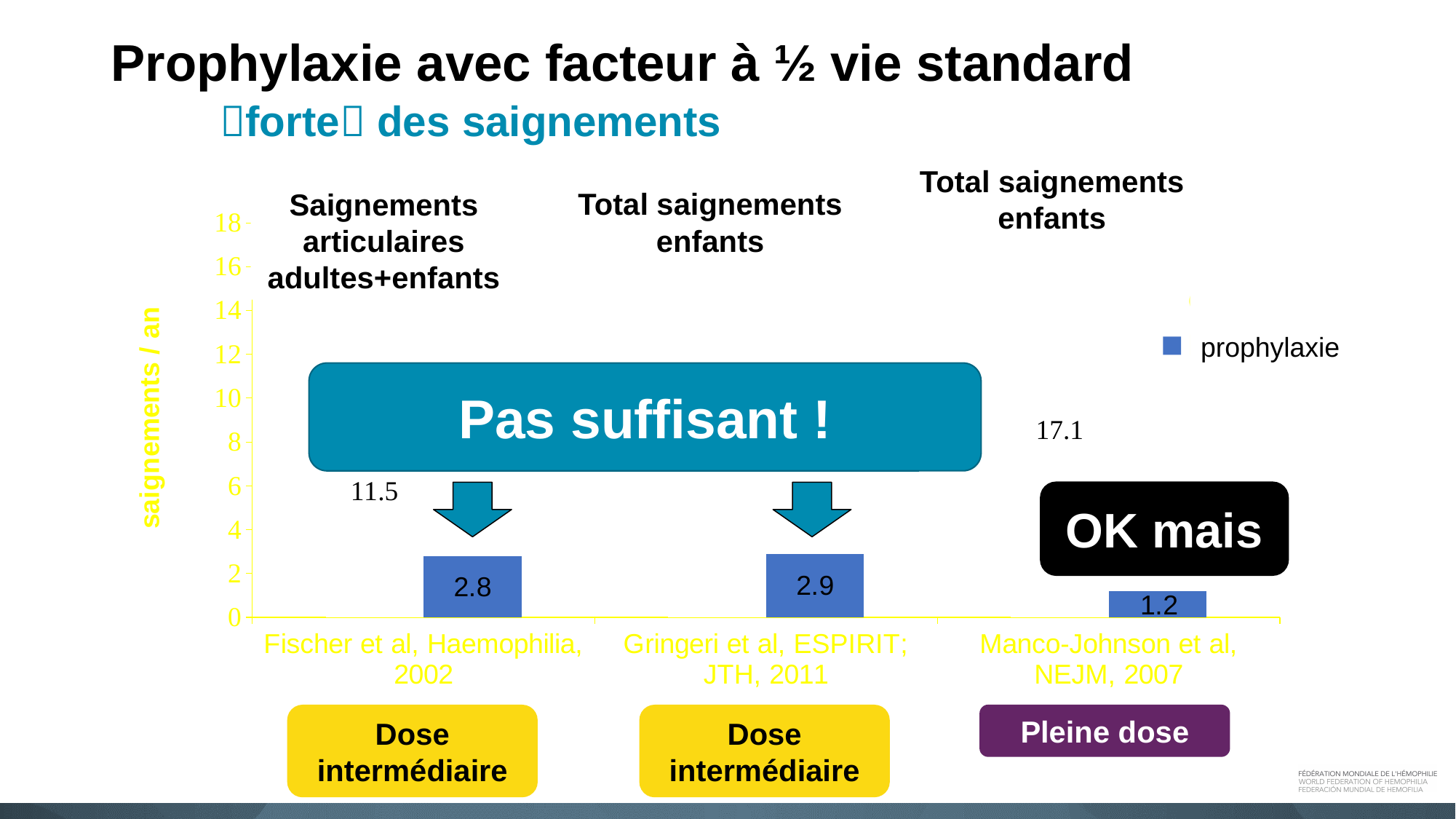
What is the difference between the prophylaxie values for Gringeri et al, ESPIRIT; JTH, 2011 and Manco-Johnson et al, NEJM, 2007? 1.7 What is the value of the prophylaxie bar for Fischer et al, Haemophilia, 2002? 2.8 Which study has the highest prophylaxie bar? Gringeri et al, ESPIRIT; JTH, 2011 Is the prophylaxie value for Fischer et al, Haemophilia, 2002 larger or smaller than the value for Manco-Johnson et al, NEJM, 2007? larger What is the label of the y axis of the chart? saignements / an Which study has the lowest prophylaxie bar? Manco-Johnson et al, NEJM, 2007 What series name is shown in the chart legend? prophylaxie What is the value of the prophylaxie bar for Gringeri et al, ESPIRIT; JTH, 2011? 2.9 What is the value of the prophylaxie bar for Manco-Johnson et al, NEJM, 2007? 1.2 How many studies are shown on the x axis of the chart? 3 Is the prophylaxie value for Gringeri et al, ESPIRIT; JTH, 2011 greater or less than 4? less What type of chart is shown on the slide? bar chart